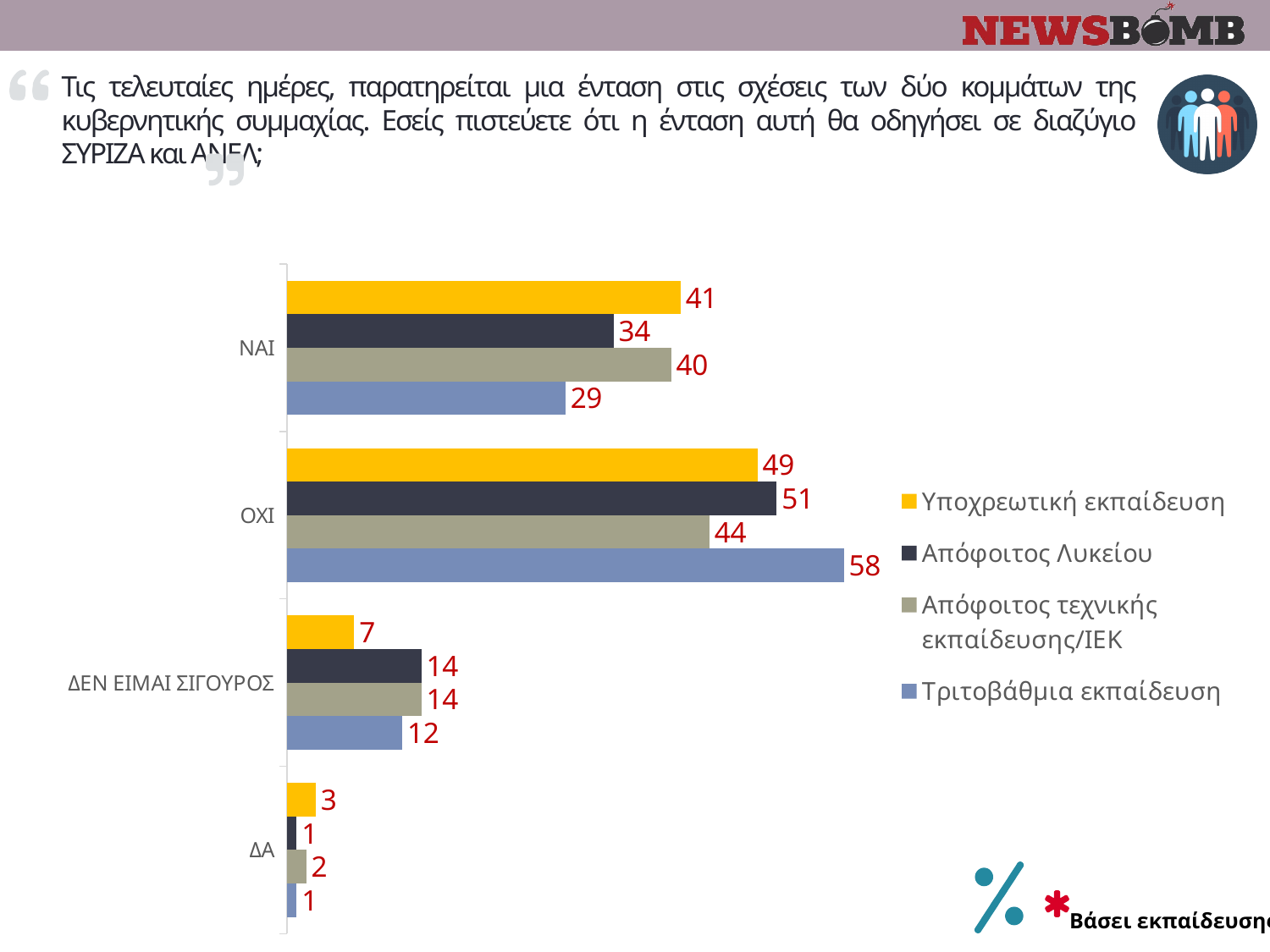
Which colour represents Υποχρεωτική εκπαίδευση in the legend? Yellow What is the difference between the ΟΧΙ and ΝΑΙ values for Τριτοβάθμια εκπαίδευση? 29 How many series does the legend list? 4 What is the value for Απόφοιτος τεχνικής εκπαίδευσης/ΙΕΚ in the ΔΑ category? 2 What is the value for Υποχρεωτική εκπαίδευση in the ΔΕΝ ΕΙΜΑΙ ΣΙΓΟΥΡΟΣ category? 7 What is the value for Απόφοιτος Λυκείου in the ΝΑΙ category? 34 Which education group has the lowest value in the ΝΑΙ category? Τριτοβάθμια εκπαίδευση Which education group has the highest value in the ΟΧΙ category? Τριτοβάθμια εκπαίδευση How many response categories are shown on the chart? 4 What is the value for Τριτοβάθμια εκπαίδευση in the ΟΧΙ category? 58 What kind of chart is shown on the slide? Bar chart Which is larger for Υποχρεωτική εκπαίδευση: the ΝΑΙ value or the ΟΧΙ value? ΟΧΙ